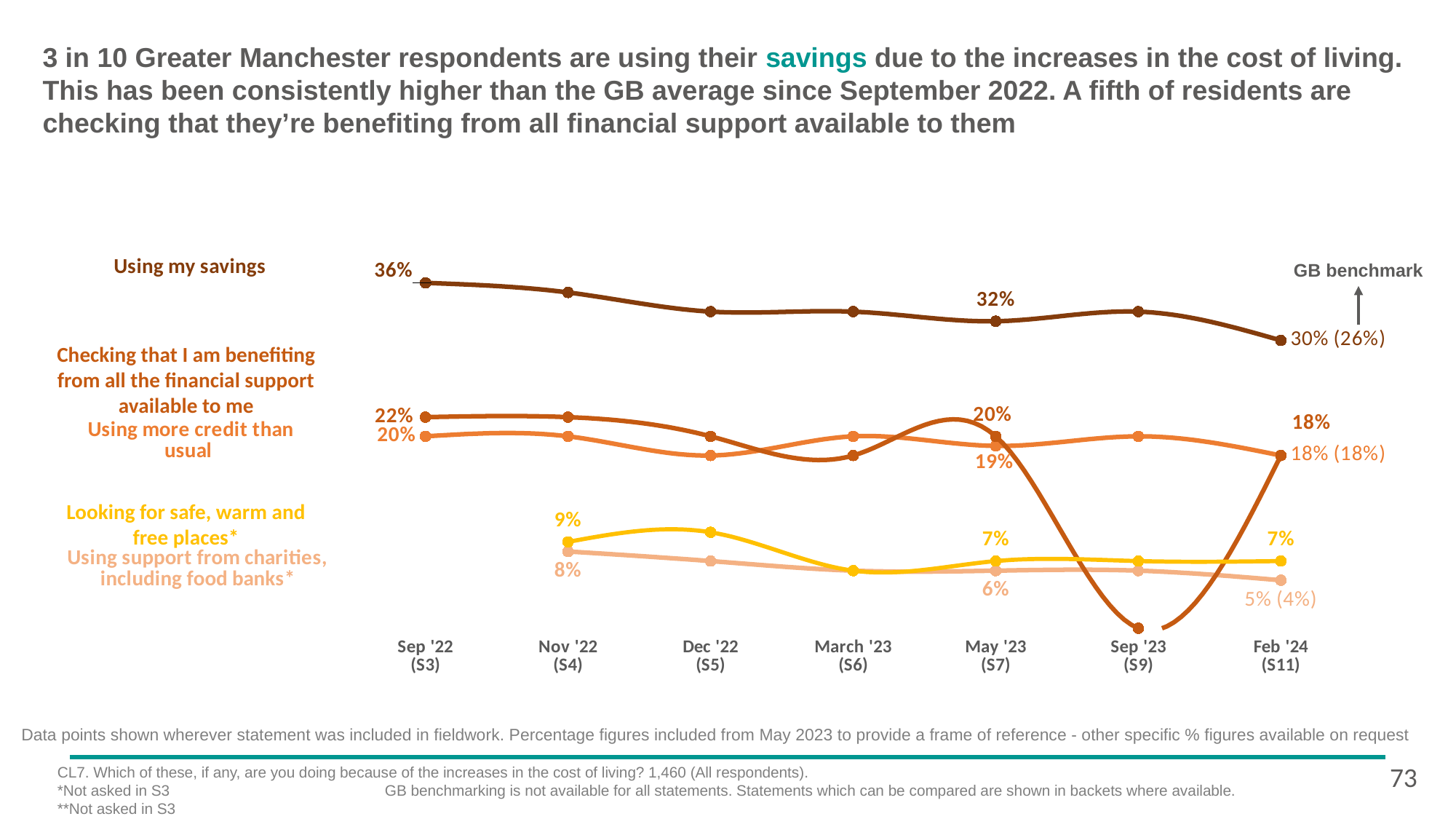
Which statement has the lowest value in Feb '24 (S11)? Using support from charities, including food banks How many time points are shown on the x axis? 7 In Nov '22, which was higher: 'Looking for safe, warm and free places' or 'Using support from charities, including food banks'? Looking for safe, warm and free places What was the value for 'Using my savings' in Sep '22 (S3)? 36% By how many percentage points did 'Using my savings' fall between Sep '22 and Feb '24? 6 percentage points What is the GB benchmark shown in brackets for 'Using my savings' in Feb '24? 26% What type of chart is shown on the slide? line chart What was the value for 'Using my savings' in Feb '24 (S11)? 30% What was the value for 'Using support from charities, including food banks' in Feb '24 (S11)? 5% Which statement has the highest value in Feb '24 (S11)? Using my savings What was the value for 'Using more credit than usual' in May '23 (S7)? 19% Does the 'Using my savings' line generally rise or fall from Sep '22 to Feb '24? fall